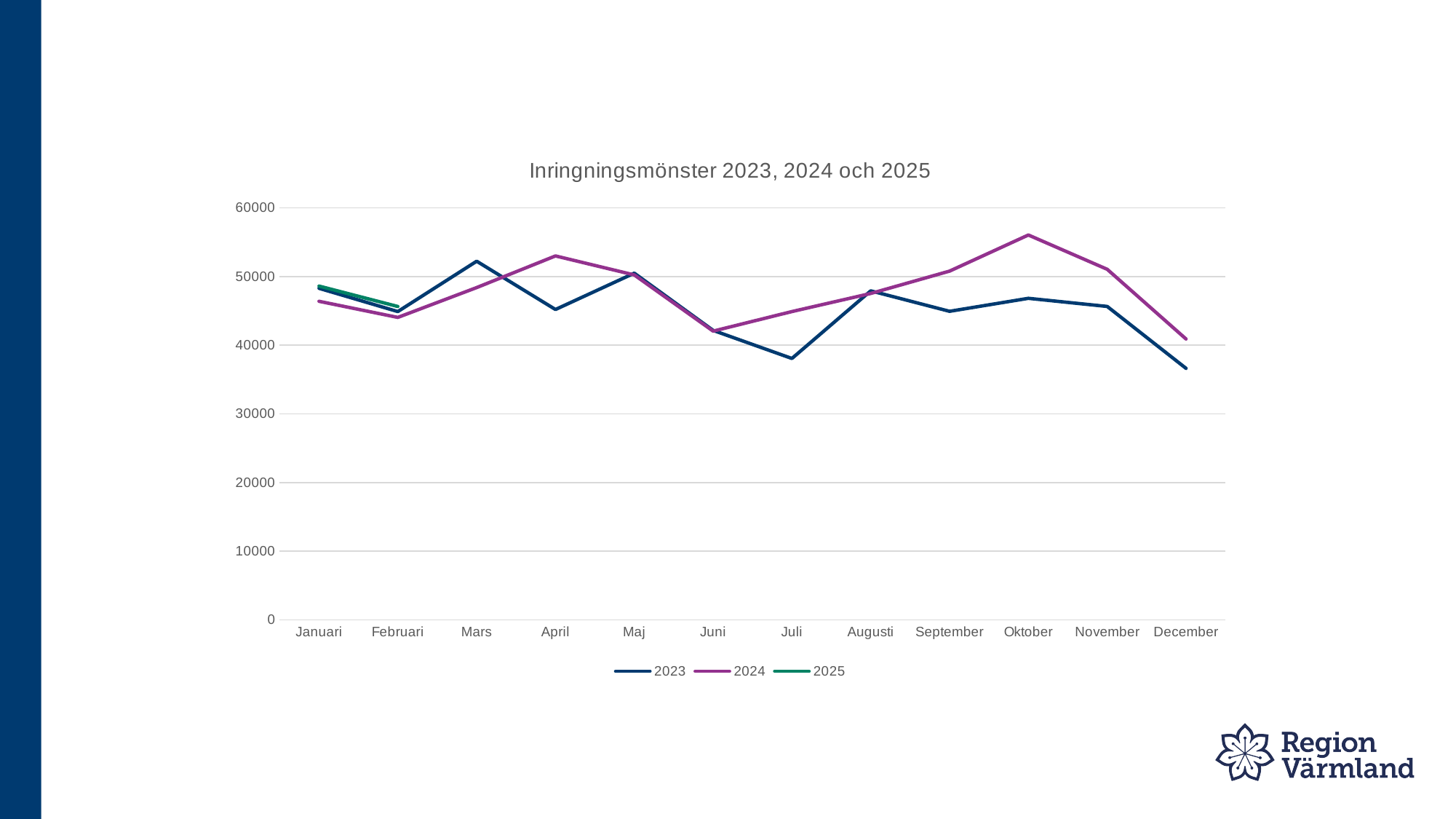
In April, which series has the larger value, 2023 or 2024? 2024 In which month does the 2023 series reach its lowest value? December What is the title of the chart? Inringningsmönster 2023, 2024 och 2025 How many months are shown on the x axis? 12 For how many months does the 2025 series have data points? 2 Is the value for 2024 in Oktober greater or less than 50000? greater Does the 2023 series rise or fall from Oktober to December? Fall What kind of chart is shown on the slide? Line chart In which month does the 2023 series reach its highest value? Mars In which month does the 2024 series reach its highest value? Oktober Is the value for 2023 in Juli greater or less than 40000? less How many series does the legend list? 3